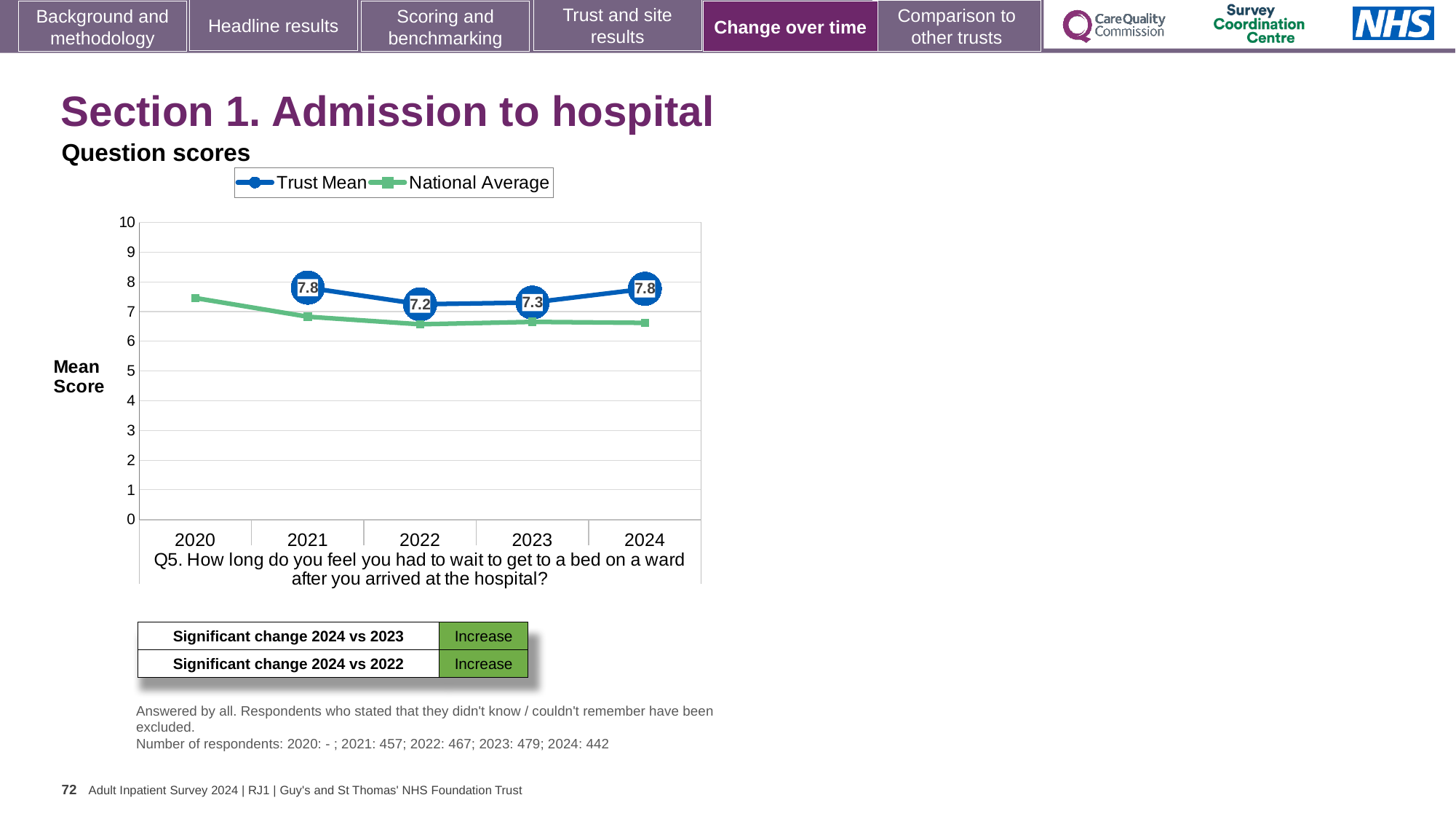
What is the Trust Mean score for 2023? 7.3 Is the National Average value for 2022 greater or less than 7? less In 2024, which series has the higher value, Trust Mean or National Average? Trust Mean How many series does the chart legend list? 2 Is the National Average value for 2020 greater or less than 7? greater What is the Trust Mean score for 2022? 7.2 What is the Trust Mean score for 2024? 7.8 Which year has the higher Trust Mean score, 2021 or 2023? 2021 How many years are shown on the x axis of the chart? 5 In which year is the Trust Mean score lowest? 2022 What kind of chart is shown on the slide? Line chart What is the difference between the Trust Mean scores for 2024 and 2022? 0.6